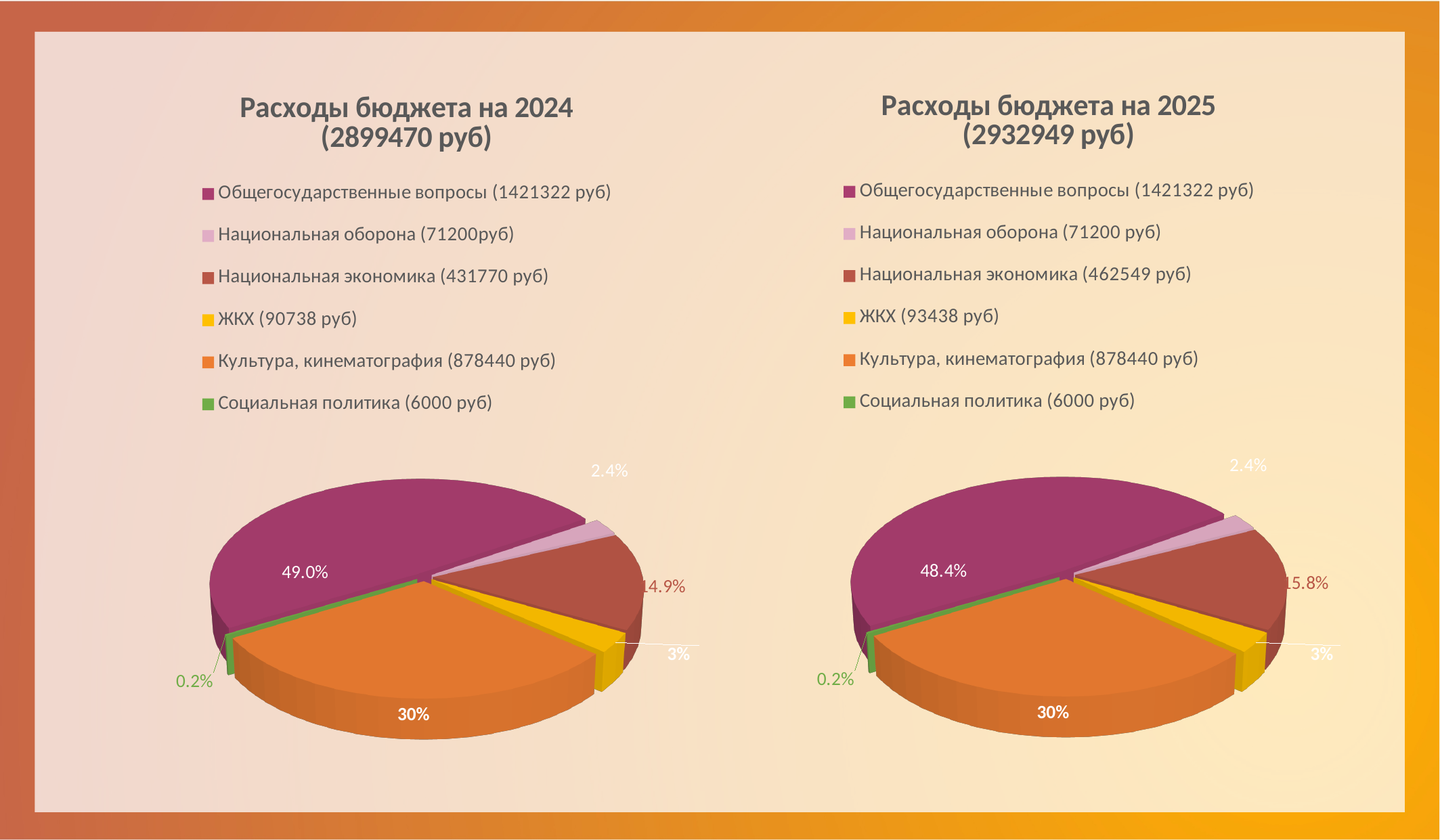
In the 'Расходы бюджета на 2025' chart, what share of the pie is 'Национальная экономика'? 15.8% In the 'Расходы бюджета на 2025' chart, which category has the smallest slice? Социальная политика In the 'Расходы бюджета на 2024' chart, what share of the pie is 'Общегосударственные вопросы'? 49.0% In the 'Расходы бюджета на 2024' chart, which category has the largest slice? Общегосударственные вопросы What type of chart is used on the slide for 'Расходы бюджета на 2024'? pie chart What is the difference between the 'Национальная экономика' values in the 2025 chart (462549 руб) and the 2024 chart (431770 руб)? 30779 руб In the 'Расходы бюджета на 2025' chart, what share of the pie is 'Общегосударственные вопросы'? 48.4% According to the legend of the 'Расходы бюджета на 2024' chart, what is the value for 'Национальная экономика'? 431770 руб According to the legend of the 'Расходы бюджета на 2025' chart, what is the value for 'ЖКХ'? 93438 руб In the 'Расходы бюджета на 2024' chart, which is larger: the slice for 'Культура, кинематография' or the slice for 'Национальная экономика'? Культура, кинематография How many categories does the 'Расходы бюджета на 2024' chart show? 6